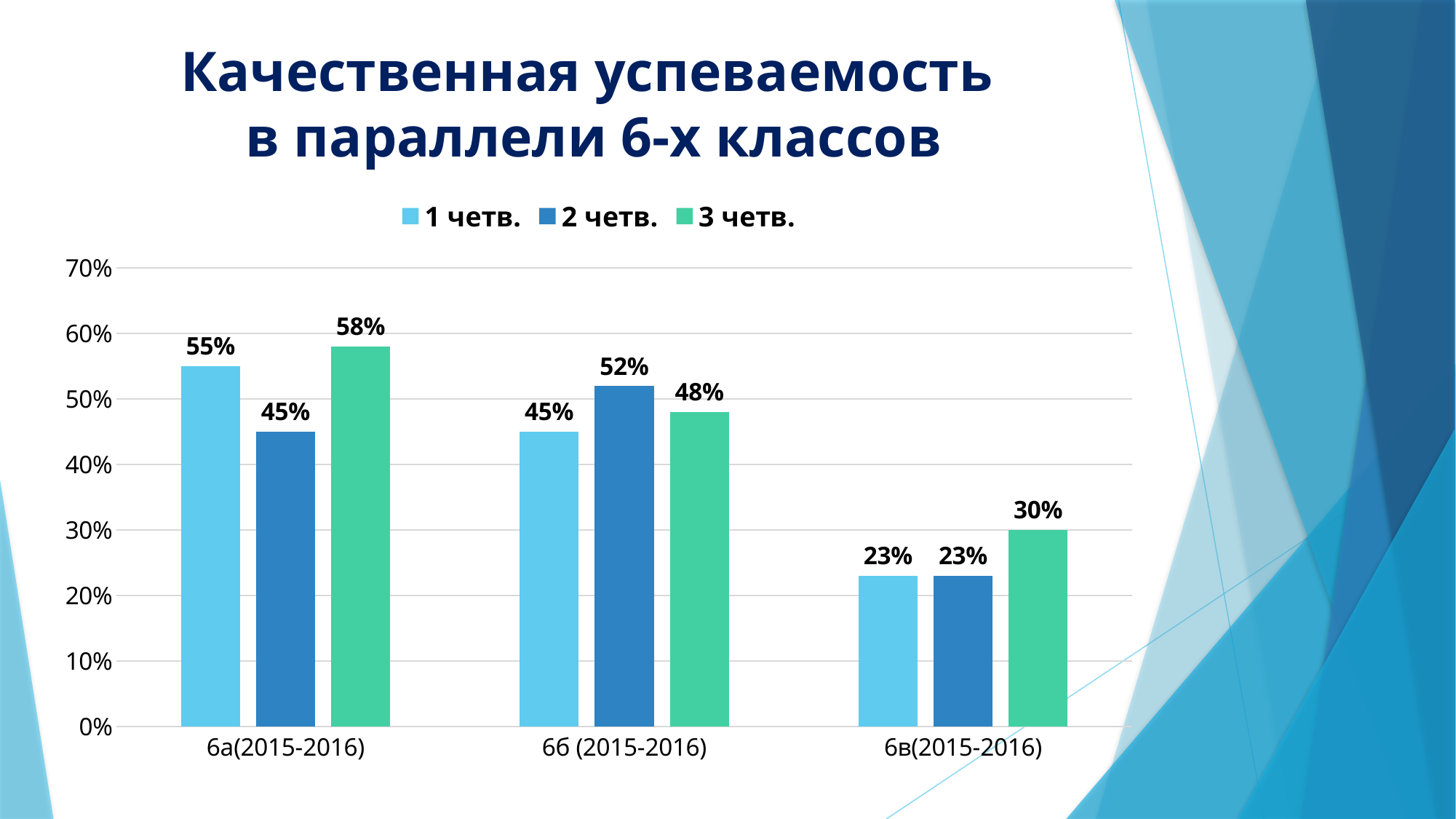
Which class has the lowest value in the 1 четв. series? 6в(2015-2016) What is the value for 6б (2015-2016) in the 2 четв. series? 52% What is the value for 6в(2015-2016) in the 3 четв. series? 30% How many classes are shown on the x axis? 3 How many series does the legend list? 3 Which class has the highest value in the 3 четв. series? 6а(2015-2016) Which is larger for 6б (2015-2016): the 2 четв. value or the 3 четв. value? 2 четв. Is the 2 четв. value for 6в(2015-2016) greater or less than 30%? less What is the title of the chart? Качественная успеваемость в параллели 6-х классов What is the difference between the 3 четв. and 2 четв. values for 6а(2015-2016)? 13% What is the value for 6а(2015-2016) in the 1 четв. series? 55% What kind of chart is shown on the slide? bar chart